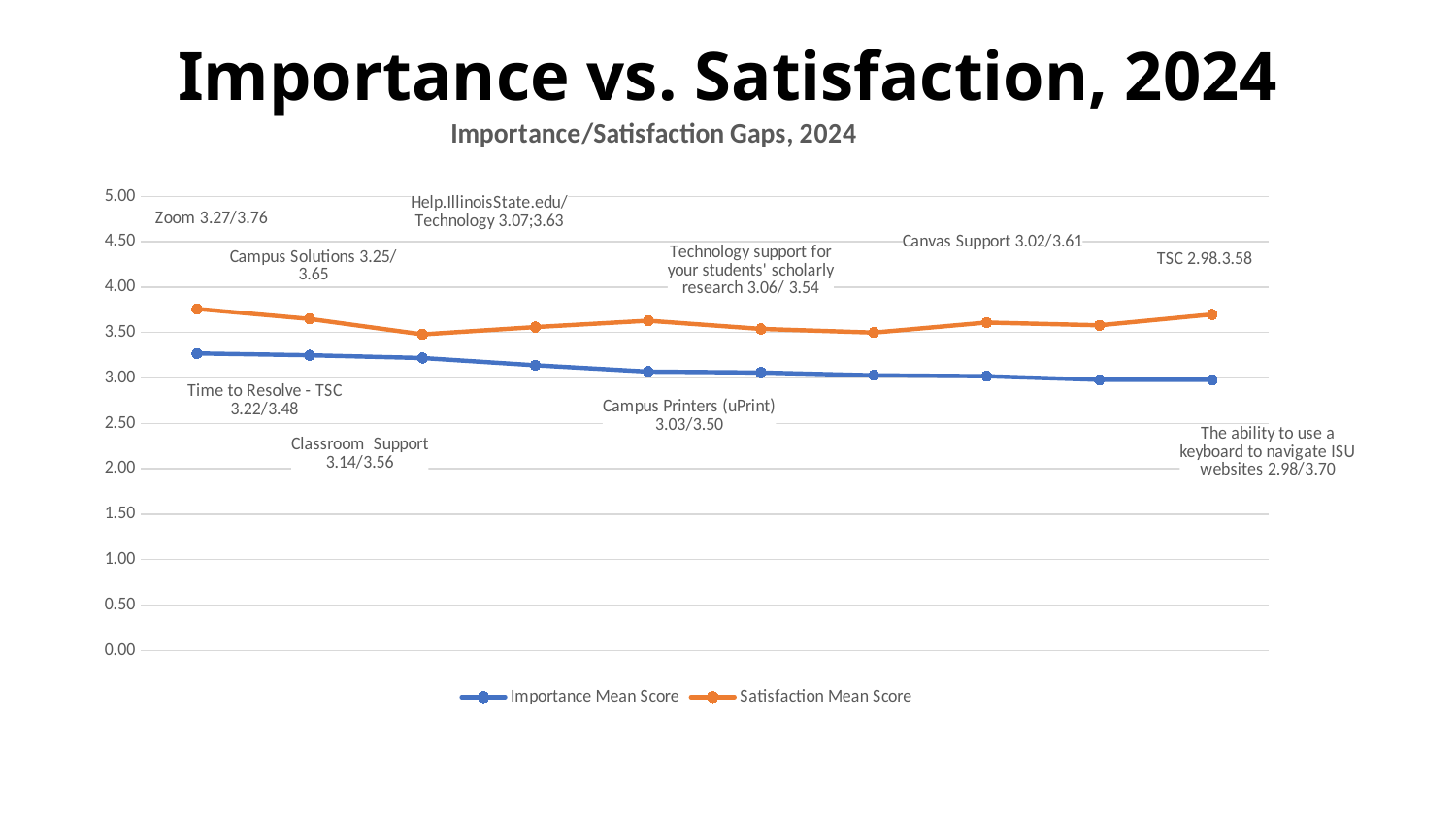
What type of chart is shown on the slide? Line chart What is the difference between the Satisfaction Mean Score and the Importance Mean Score for Zoom? 0.49 What is the Satisfaction Mean Score for Zoom? 3.76 Does the Importance Mean Score line generally rise or fall from left to right? Fall What is the Satisfaction Mean Score for Classroom Support? 3.56 What is the title of the chart? Importance/Satisfaction Gaps, 2024 What is the Importance Mean Score for Zoom? 3.27 Is the Importance Mean Score for Zoom greater or less than 3.00? greater Which item has the highest Satisfaction Mean Score? Zoom How many data points does each line have? 10 For Canvas Support, which is larger: the Importance Mean Score or the Satisfaction Mean Score? Satisfaction Mean Score How many series does the legend list? 2